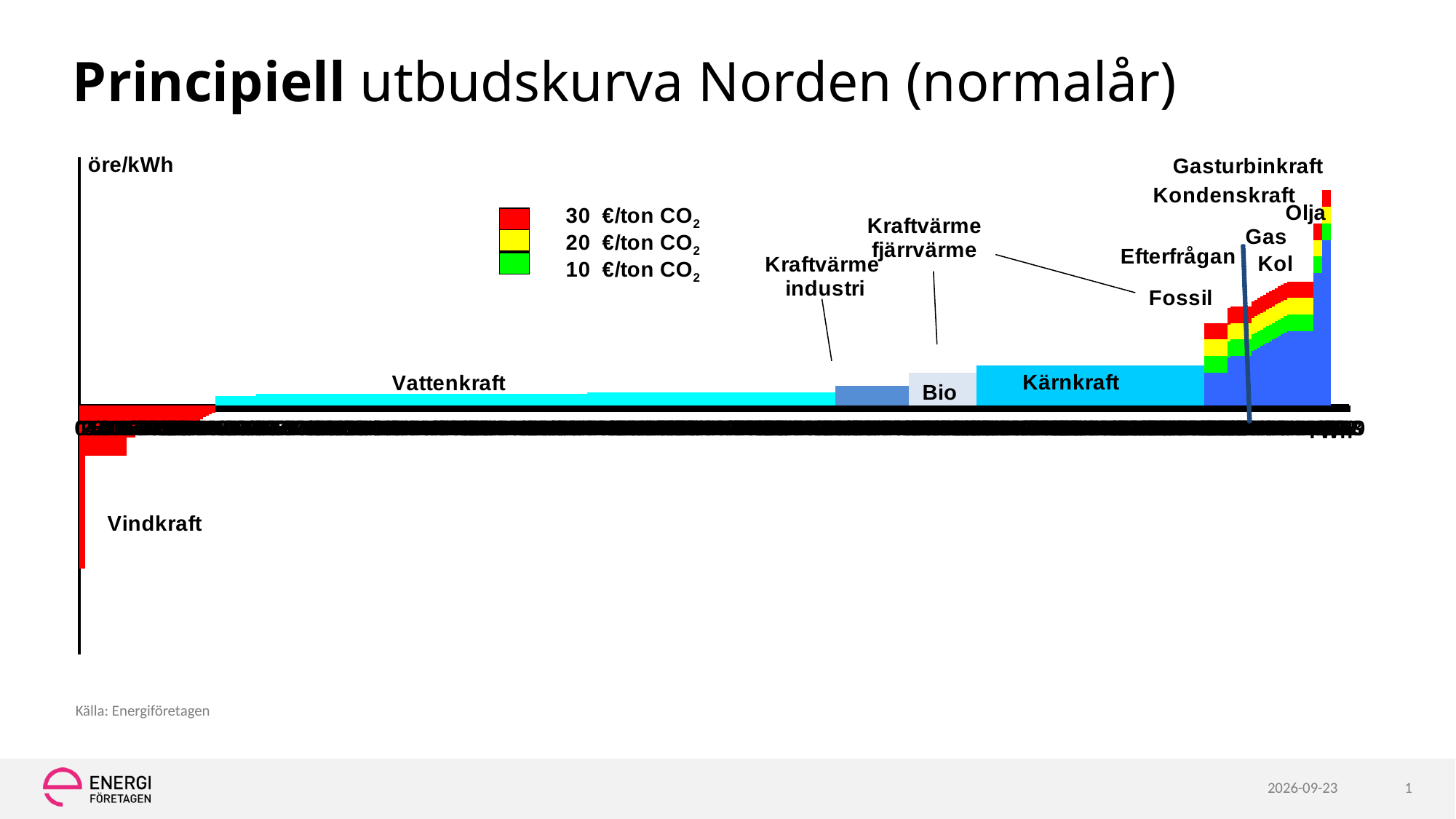
Which technology is plotted below the horizontal axis, with a negative value? Vindkraft How many CO2 price levels does the legend list? 3 What unit is shown on the vertical axis of the chart? öre/kWh Which colour in the legend represents 30 €/ton CO2? Red Is Kärnkraft plotted higher or lower on the curve than Vattenkraft? Higher Is Kol plotted higher or lower on the curve than Olja? Lower Do the values of the supply curve rise or fall from left to right? Rise Which is plotted higher on the curve, Fossil or Bio? Fossil Which technology is at the highest point of the supply curve? Gasturbinkraft